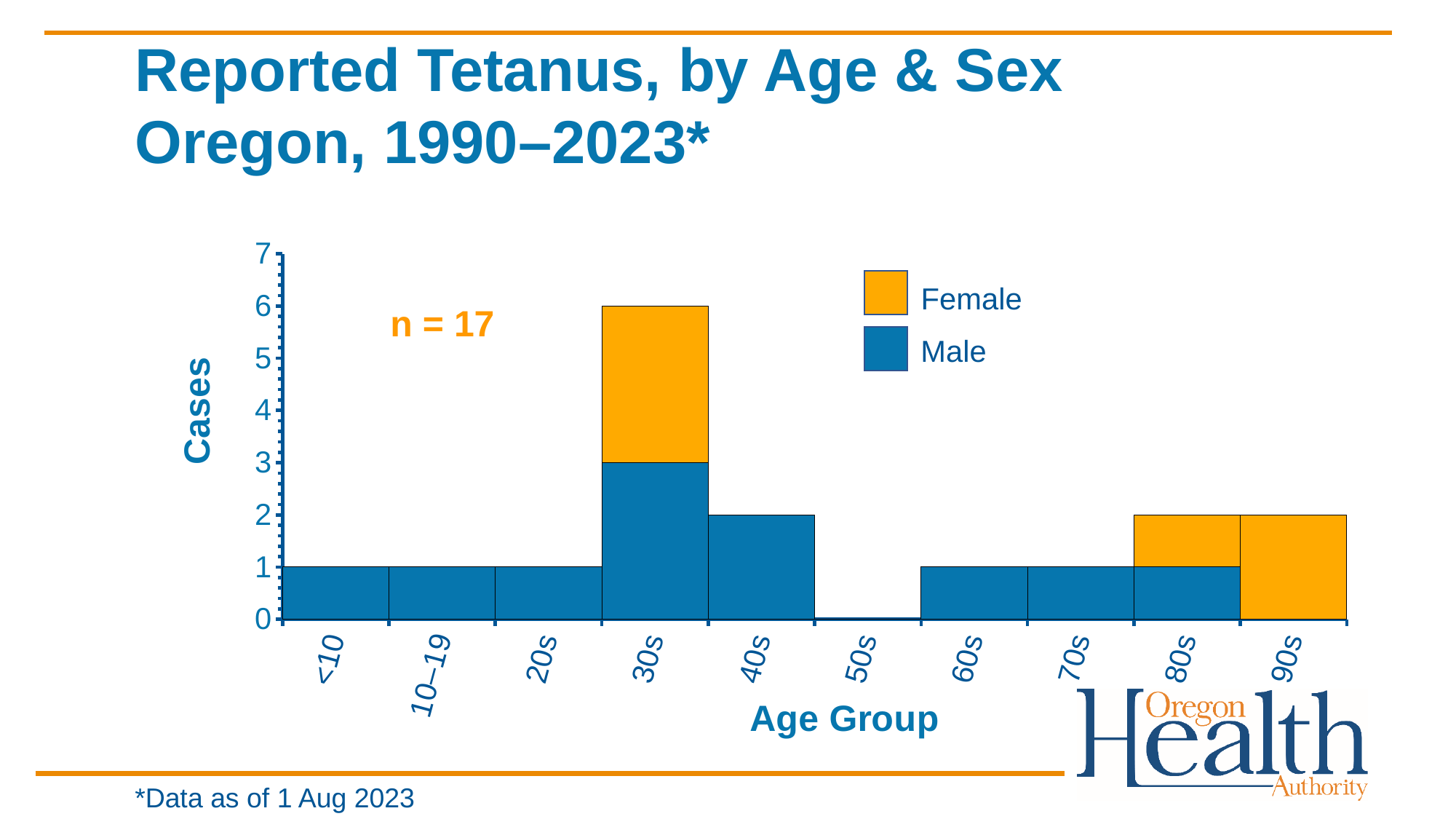
How many Female cases are in the 90s age group? 2 What kind of chart is shown on the slide? stacked bar chart What total sample size (n) is printed on the chart? n = 17 Which has more total cases, the 80s age group or the 70s age group? 80s Which age group has the highest total number of cases? 30s What is the difference between the total cases in the 30s age group and the 40s age group? 4 Which age group has the lowest total number of cases? 50s How many Male cases are in the 30s age group? 3 How many series does the legend list? 2 How many age groups are shown on the x axis? 10 What is the total number of cases for the 30s age group? 6 How many Male cases are in the 40s age group? 2